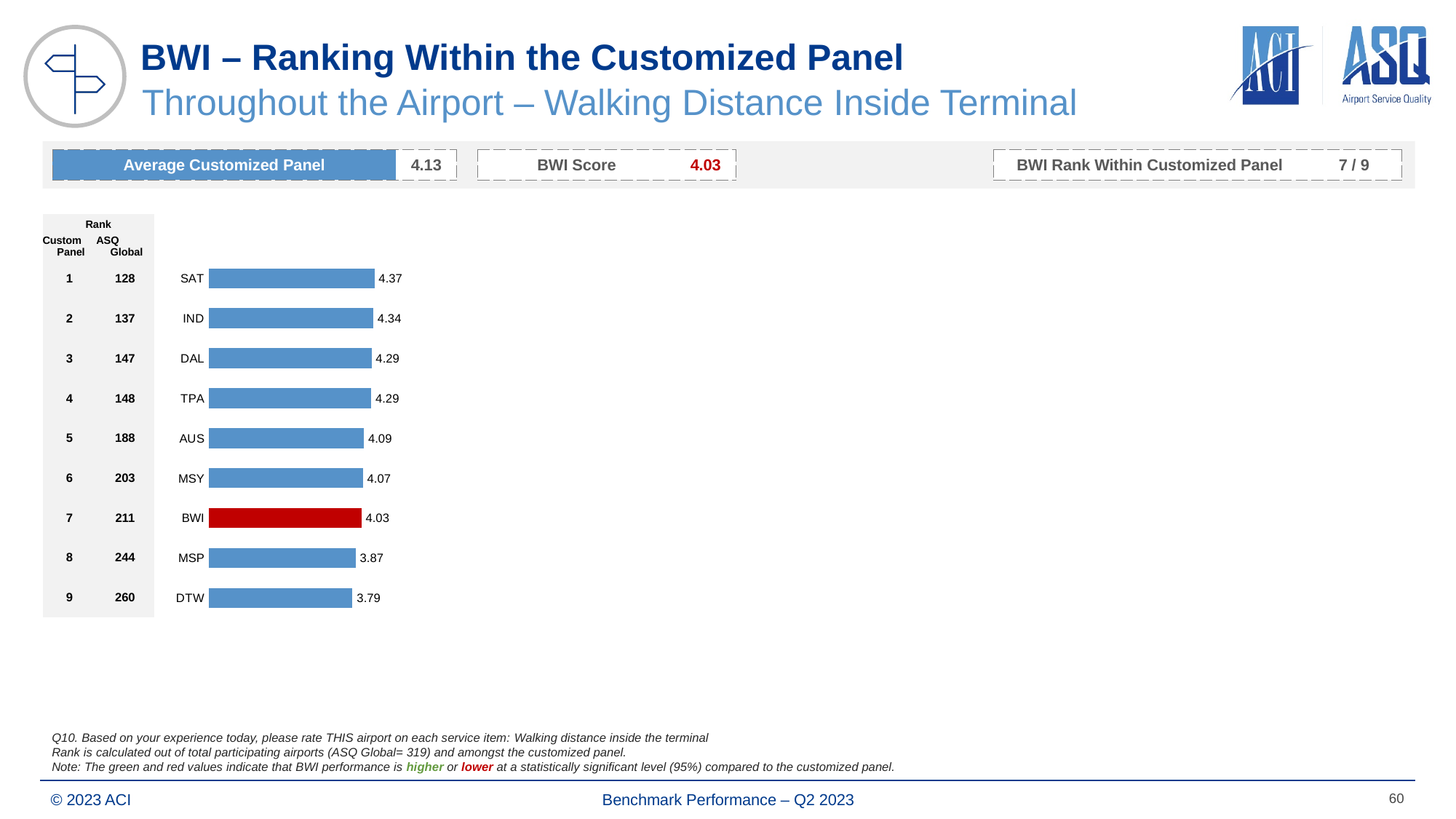
Which airport has the lowest value? DTW What is the value for BWI? 4.03 What kind of chart is shown on the slide? Bar chart Which airport has the highest value? SAT What is the value for MSP? 3.87 Which bar is coloured red? BWI What is the value for DTW? 3.79 Which has a larger value, AUS or MSY? AUS What is the value for SAT? 4.37 How many airports are shown in the chart? 9 What is the difference between the values for BWI and MSP? 0.16 What is the difference between the values for SAT and DTW? 0.58